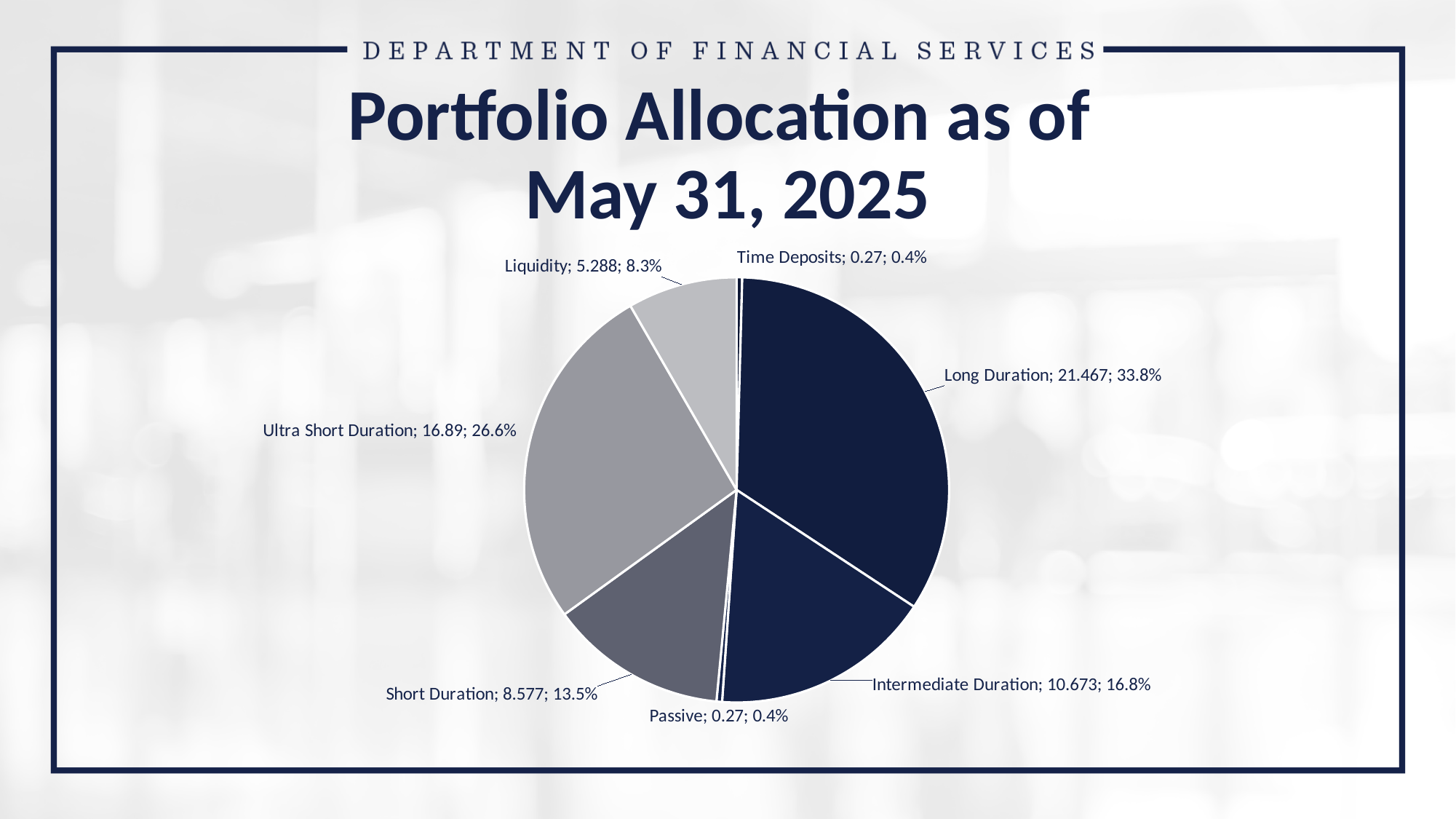
How many slices does the pie chart have? 7 Which category has the largest share of the pie? Long Duration What share of the pie does Passive represent? 0.4% What is the difference between the Long Duration value and the Ultra Short Duration value? 4.577 What percentage of the portfolio is Liquidity? 8.3% What kind of chart is shown on the slide? Pie chart What is the value shown for Short Duration? 8.577 What is the value shown for Intermediate Duration? 10.673 What is the title of the chart on the slide? Portfolio Allocation as of May 31, 2025 Which is larger, Intermediate Duration or Short Duration? Intermediate Duration What is the value shown for Long Duration? 21.467 What share of the pie does Ultra Short Duration represent? 26.6%